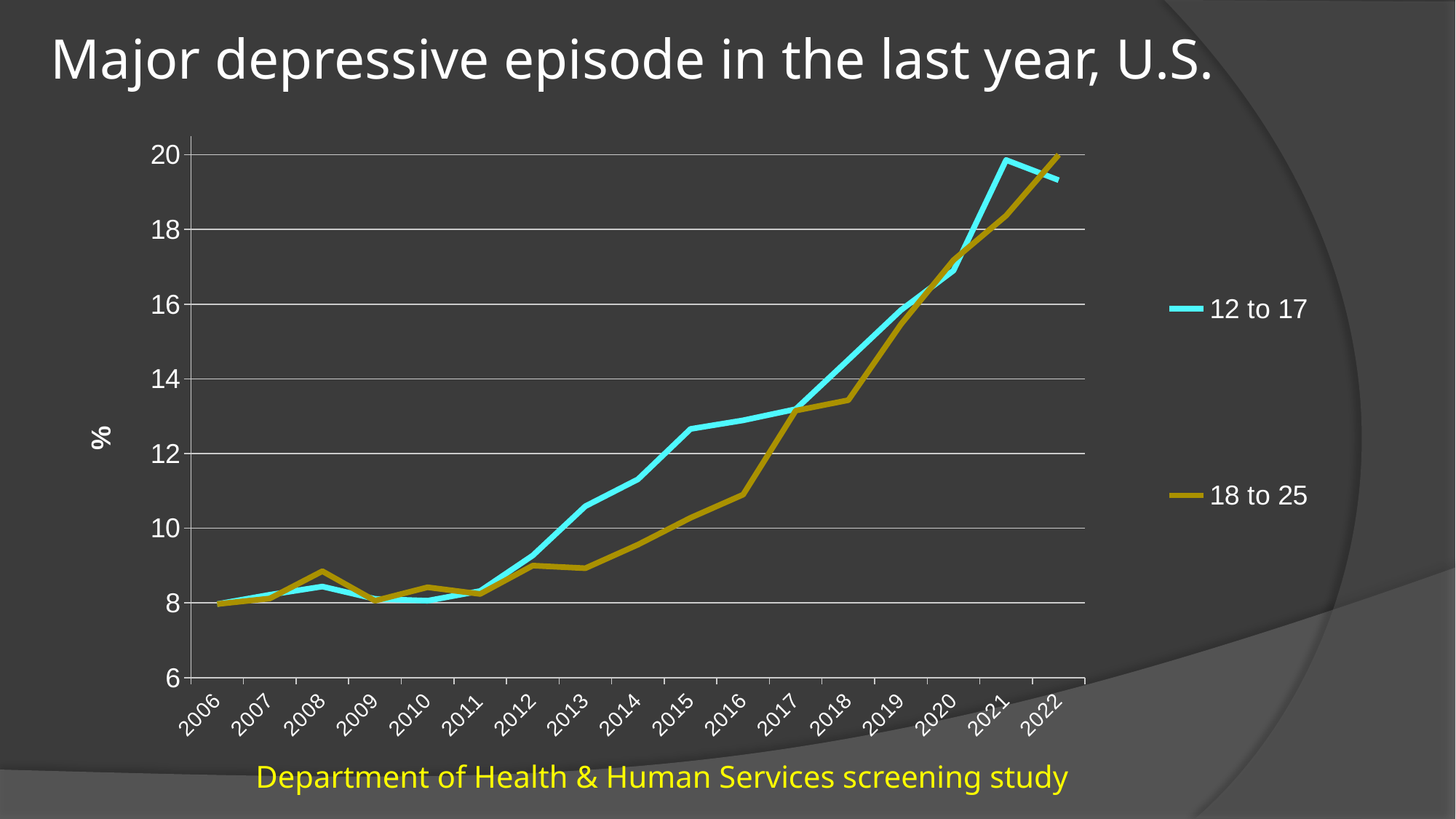
Do the values for the 18 to 25 series generally rise or fall from 2006 to 2022? rise What is the title of the chart? Major depressive episode in the last year, U.S. Is the value for 12 to 17 in 2015 greater or less than 12? greater Which year has the highest value for the 18 to 25 series? 2022 Is the value for 18 to 25 in 2018 greater or less than 14? less Which year has the highest value for the 12 to 17 series? 2021 In 2015, which series has the larger value, 12 to 17 or 18 to 25? 12 to 17 Is the value for 18 to 25 in 2013 greater or less than 10? less How many series does the legend list? 2 What kind of chart is shown on the slide? line chart How many years are plotted along the x axis? 17